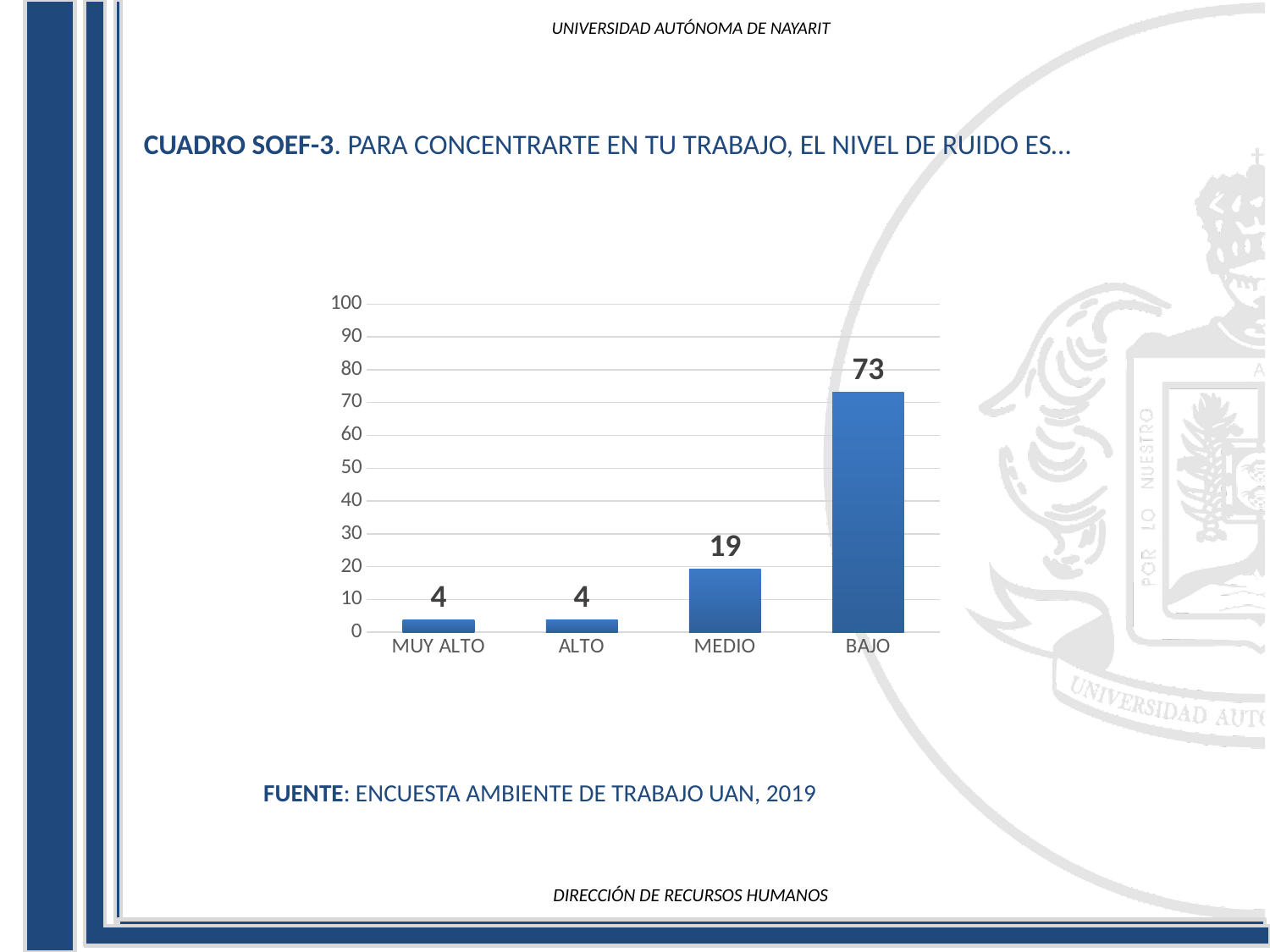
What kind of chart is shown on the slide? bar chart What is the value for MUY ALTO? 4 What is the source cited below the chart? ENCUESTA AMBIENTE DE TRABAJO UAN, 2019 Which category has the highest value? BAJO What is the difference between the values for BAJO and MEDIO? 54 Is the value for BAJO greater or less than 50? greater How many categories are shown on the x axis? 4 Which is larger, the value for MEDIO or the value for ALTO? MEDIO What is the value for MEDIO? 19 What is the difference between the values for MEDIO and ALTO? 15 Do the values rise or fall from MUY ALTO to BAJO along the x axis? rise What is the value for BAJO? 73